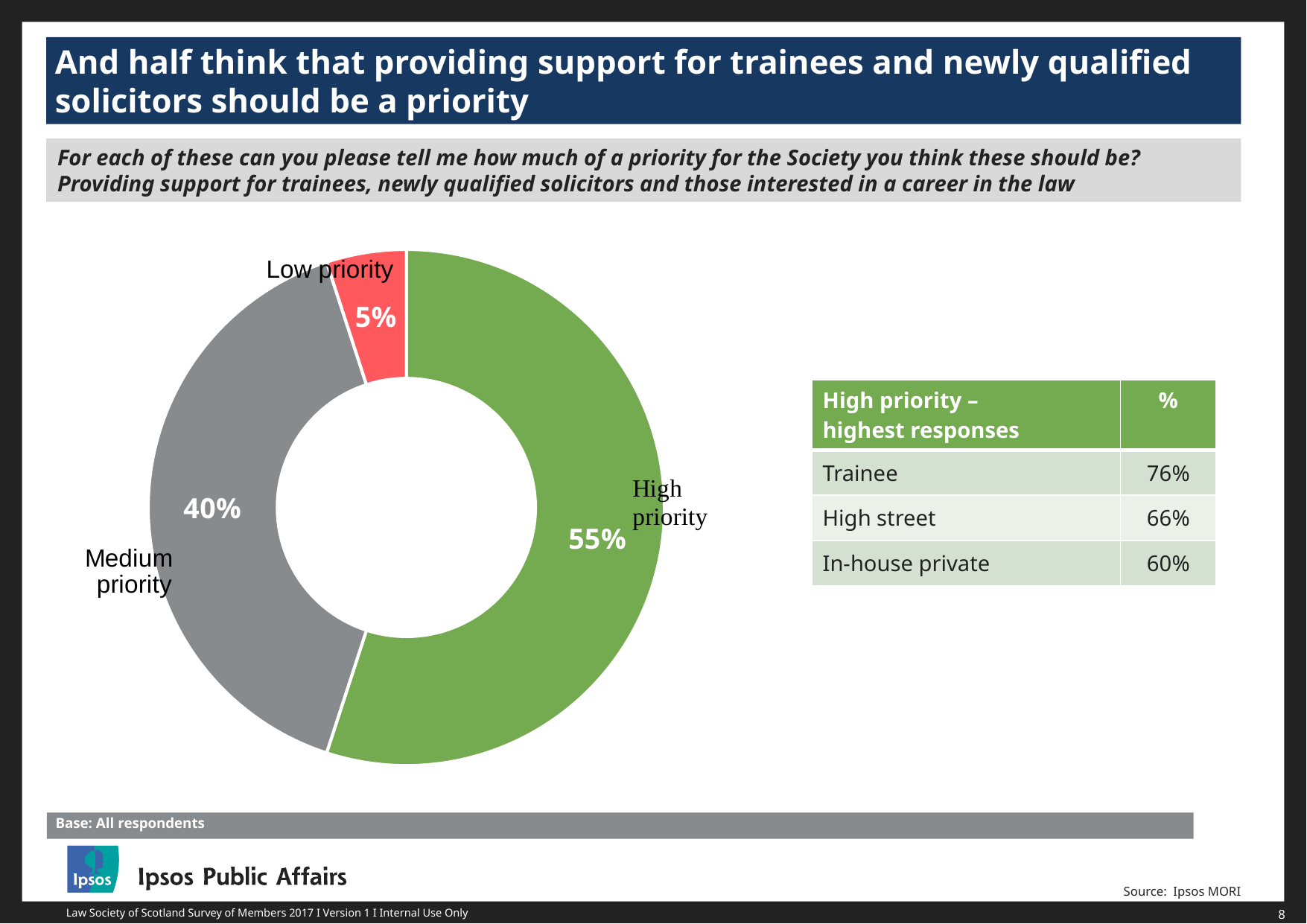
Which priority level has the largest share of the pie chart? High priority What percentage of respondents said providing support for trainees and newly qualified solicitors should be a high priority? 55% What colour is the high priority slice of the pie chart? Green What is the difference in percentage points between the high priority and medium priority shares? 15 How many slices does the pie chart have? 3 What percentage of respondents said this should be a medium priority? 40% What colour is the low priority slice of the pie chart? Red Which priority level has the smallest share of the pie chart? Low priority What is the combined share of the high priority and medium priority slices? 95% What kind of chart is shown on the slide? Pie chart (doughnut) What percentage of respondents said this should be a low priority? 5% Which is larger, the medium priority share or the low priority share? Medium priority